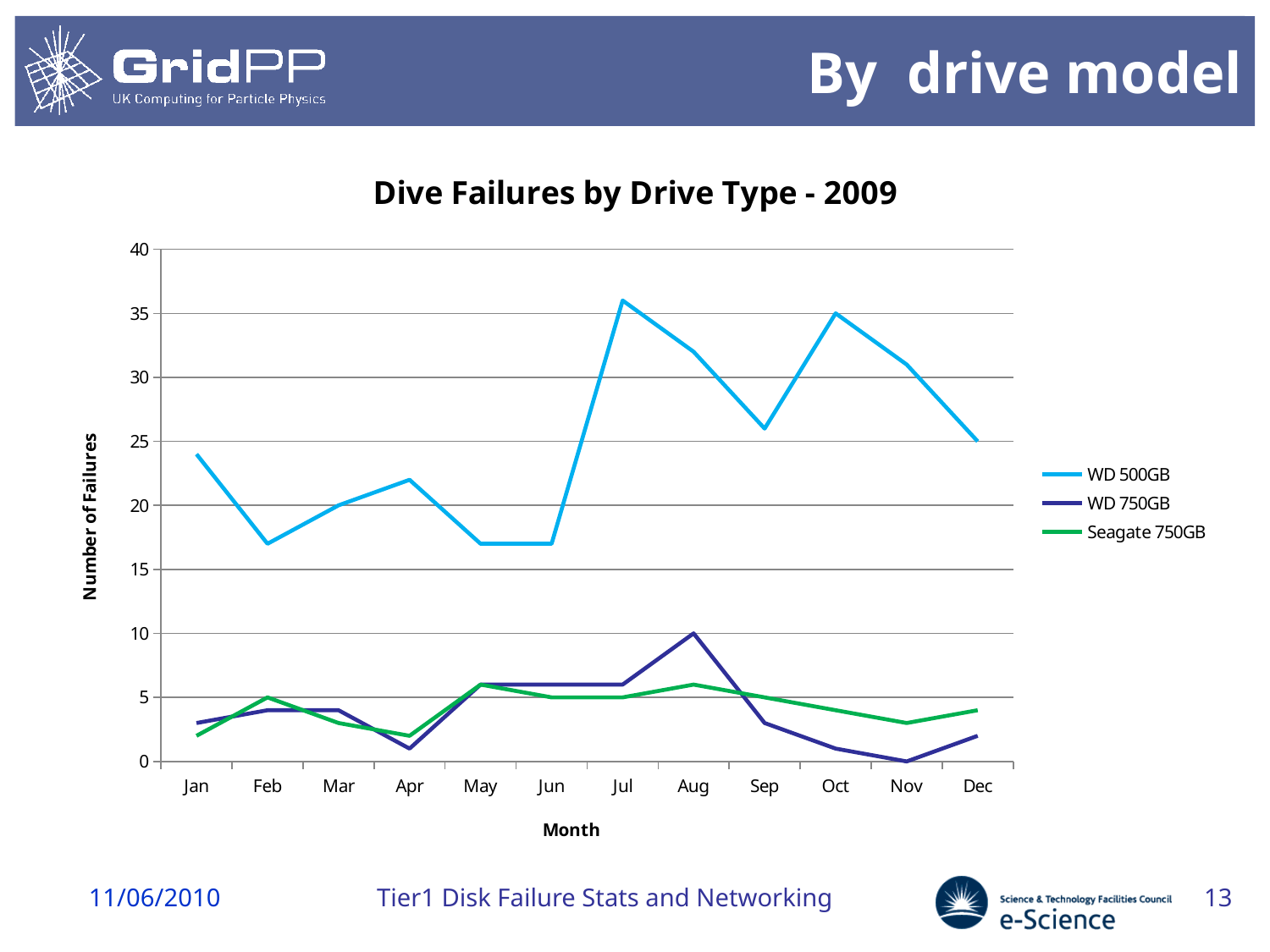
Is the value for WD 500GB in Jul greater or less than 35? greater In which month does WD 750GB have its lowest number of failures? Nov What is the number of failures for WD 500GB in Oct? 35 What kind of chart is shown on the slide? line chart In which month does WD 500GB reach its highest number of failures? Jul Do the WD 500GB failures rise or fall from Oct to Dec? fall How many months are plotted along the x axis? 12 How many series does the legend list? 3 What is the number of failures for WD 500GB in Dec? 25 What is the number of failures for WD 750GB in Nov? 0 What is the number of failures for WD 750GB in Aug? 10 Which series has more failures in Jan, WD 500GB or Seagate 750GB? WD 500GB